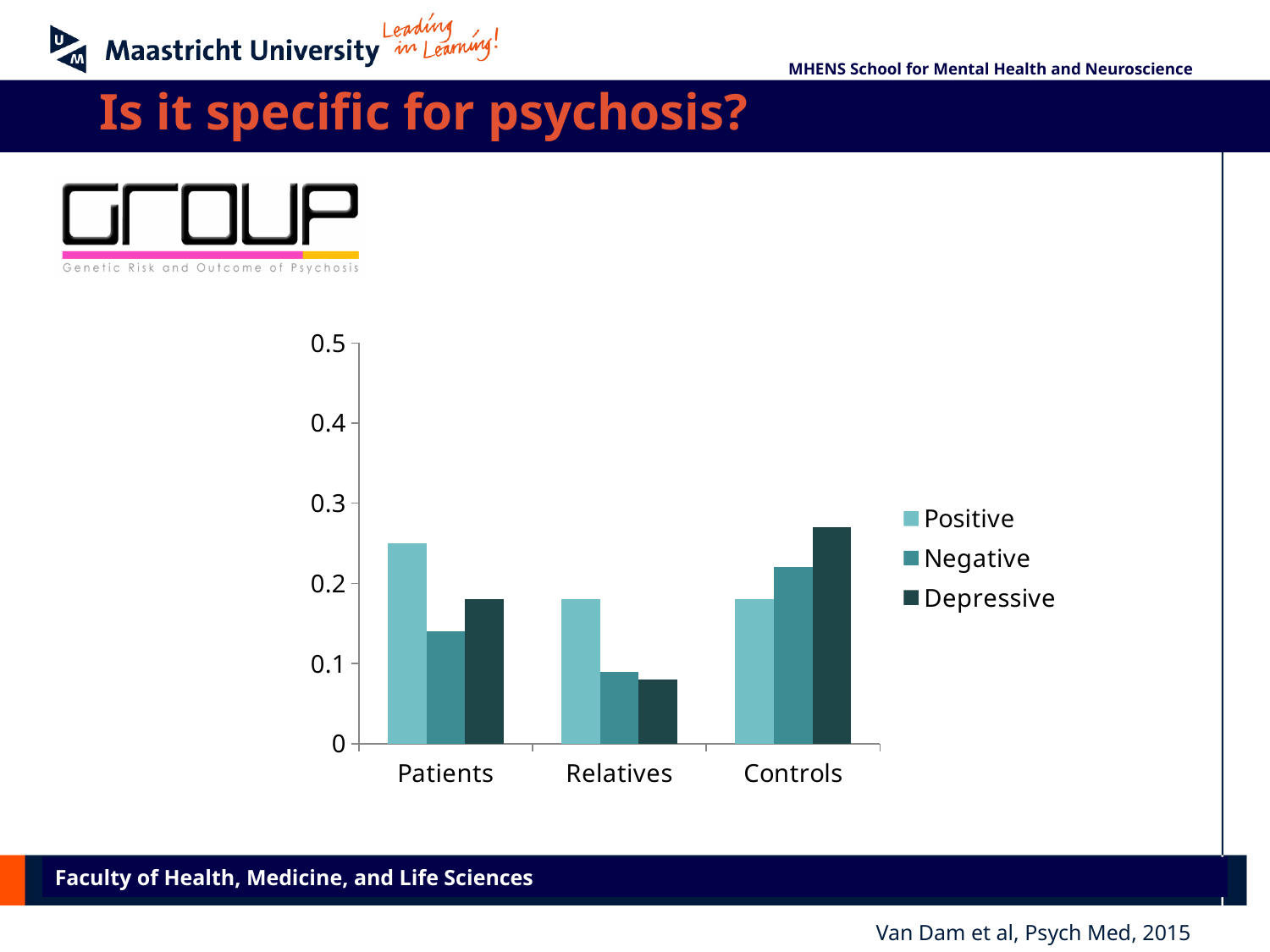
Is the Depressive value for Controls greater or less than 0.2? greater Is the Positive value for Patients greater or less than 0.2? greater How many series does the chart's legend list? 3 For Patients, which is larger: the Positive value or the Negative value? Positive Which series has the highest value for Controls? Depressive Is the Negative value for Patients greater or less than 0.2? less Which series are listed in the chart's legend? Positive, Negative, Depressive Which series has the highest value for Patients? Positive How many categories are shown on the x axis of the chart? 3 What kind of chart is shown on the slide? bar chart Which group has the larger Depressive value: Relatives or Controls? Controls